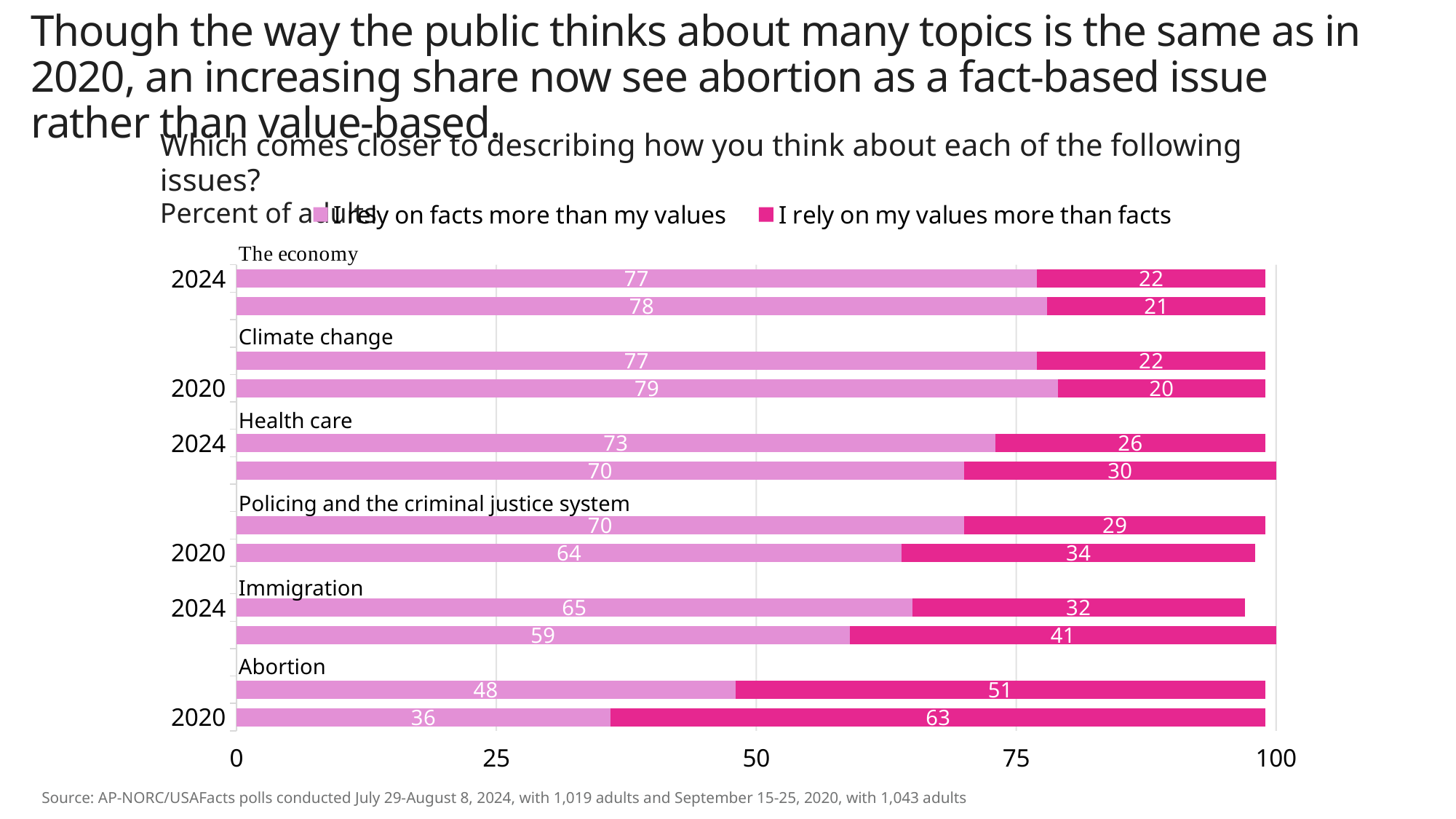
What percent of adults said they rely on facts more than values on abortion in 2024? 48 Which is larger: the 2024 'I rely on my values more than facts' value for immigration or for policing and the criminal justice system? Immigration What type of chart is shown on the slide? Stacked bar chart Which issue has the highest share of adults relying on facts more than values in 2020? Climate change How many issues are shown in the chart? 6 Which legend entry is shown in the darker pink colour? I rely on my values more than facts What is the total of the 2024 health care bar (facts plus values)? 99 What percent of adults said they rely on values more than facts on abortion in 2020? 63 How many series does the legend list? 2 What is the difference between the 2024 and 2020 'I rely on facts more than my values' values for abortion? 12 What percent of adults said they rely on facts more than values on immigration in 2020? 59 Which issue has the lowest share of adults relying on facts more than values in 2024? Abortion